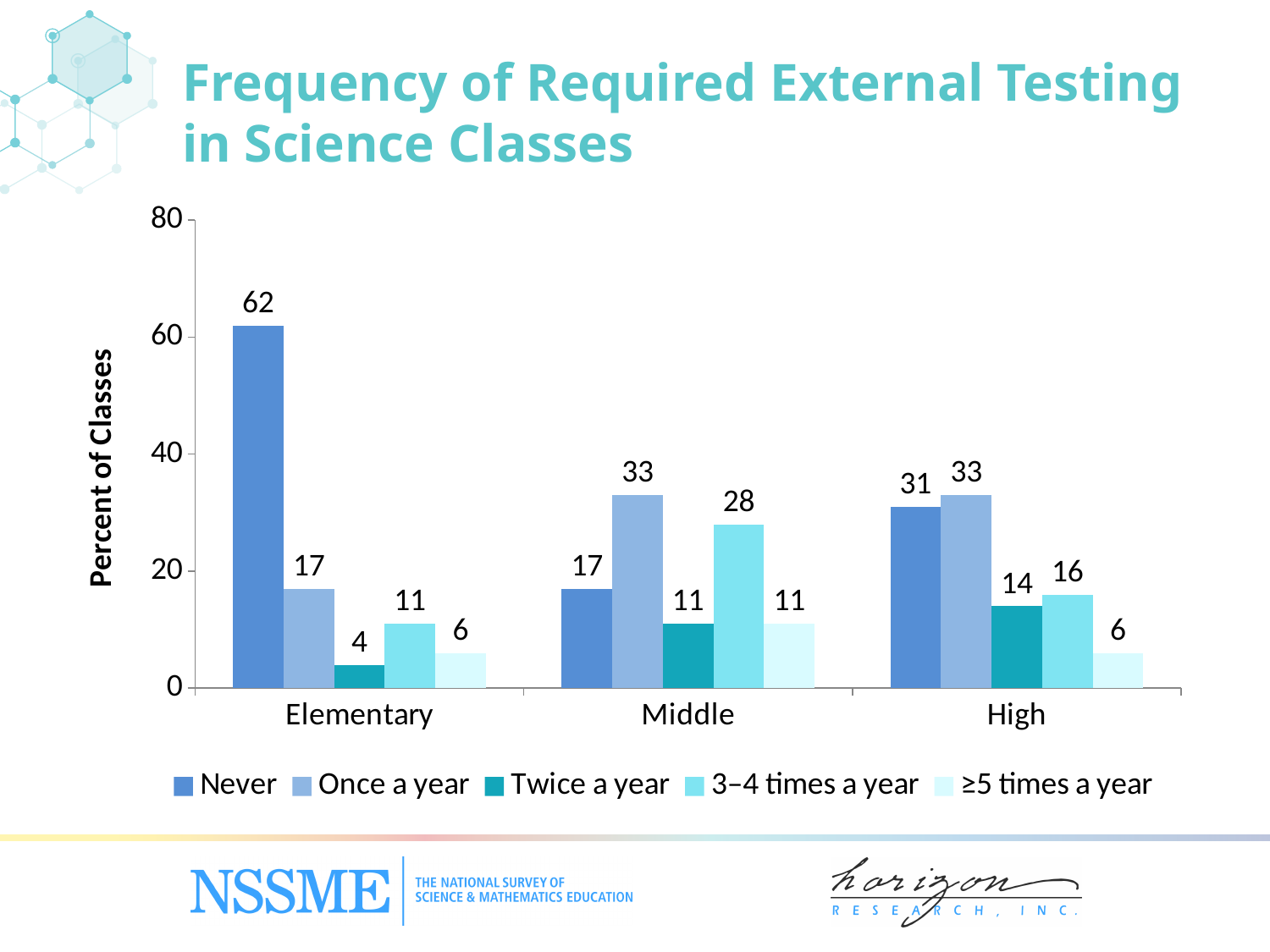
Which category has the highest value for the 'Never' series? Elementary Which is larger in the Middle category: 'Once a year' or '3–4 times a year'? Once a year How many categories are shown on the x axis? 3 Which series has the lowest value in the Elementary category? Twice a year What is the value for 'Once a year' in the Middle category? 33 What is the difference between the 'Never' values for Elementary and High? 31 How many series does the legend list? 5 Is the value for 'Never' in the Elementary category greater or less than 60? greater What is the label of the y axis? Percent of Classes What kind of chart is shown on the slide? Bar chart What percent of Elementary science classes report 'Never' for required external testing? 62 What is the value for '3–4 times a year' in the High category? 16